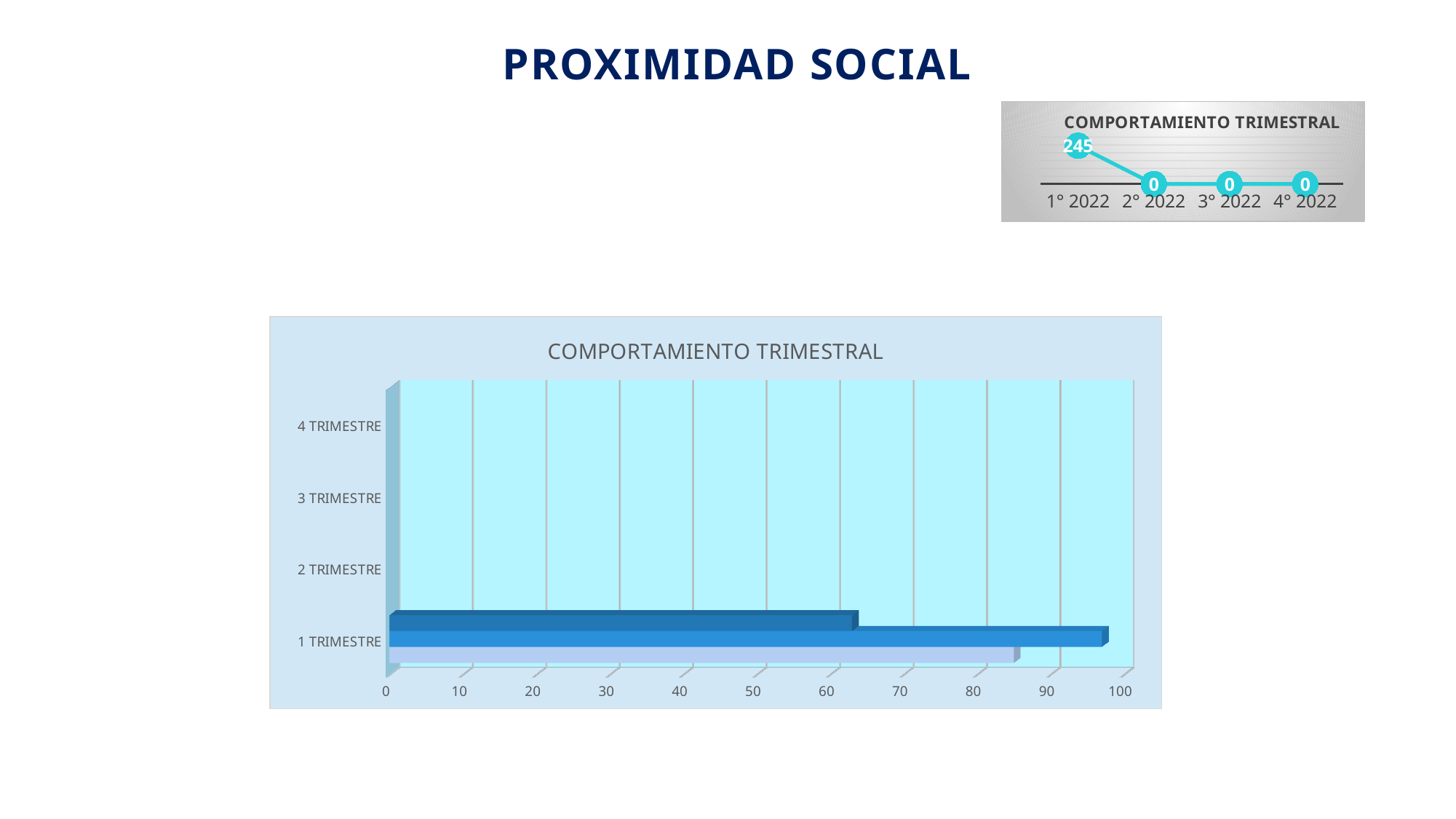
In the line chart at the top right, do the values rise or fall from 1° 2022 to 4° 2022? fall In the line chart at the top right, what is the value for 1° 2022? 245 In the bar chart at the bottom, how many categories are listed on the vertical axis? 4 What kind of chart is the large chart at the bottom of the slide? bar chart In the bar chart at the bottom, is the value of the longest bar for 1 TRIMESTRE greater or less than 90? greater In the bar chart at the bottom, which category is the only one with visible bars? 1 TRIMESTRE In the line chart at the top right, what is the difference between the values for 1° 2022 and 2° 2022? 245 In the bar chart at the bottom, is the value of the topmost (dark blue) bar for 1 TRIMESTRE greater or less than 70? less In the line chart at the top right, how many data points are plotted? 4 In the line chart at the top right, which quarter has the highest value? 1° 2022 In the line chart at the top right, what is the value for 3° 2022? 0 What kind of chart is the small chart at the top right of the slide? line chart